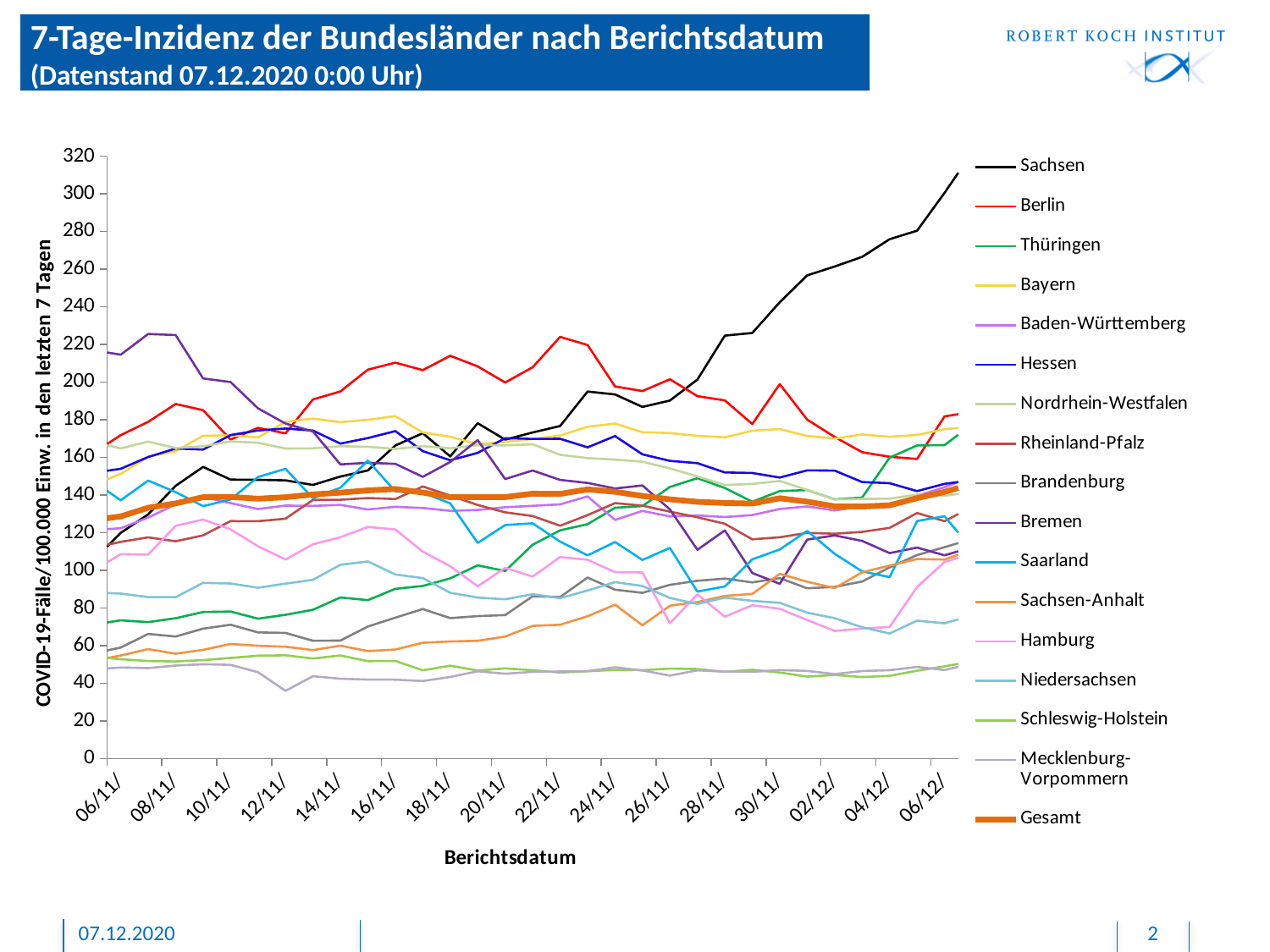
Does the value for Sachsen rise or fall between 26/11 and 06/12? rise Is the value for Gesamt on 06/11 greater or less than 140? less Is the value for Hamburg on 04/12 greater or less than 80? less Is the value for Bremen on 06/11 greater or less than 200? greater How many series does the legend list? 17 What kind of chart is shown on the slide? line chart How many date labels are shown on the x axis? 16 On 06/12, which is larger: the value for Sachsen or the value for Berlin? Sachsen Which series has the highest value at the last date, 06/12? Sachsen What is the label of the x axis? Berichtsdatum